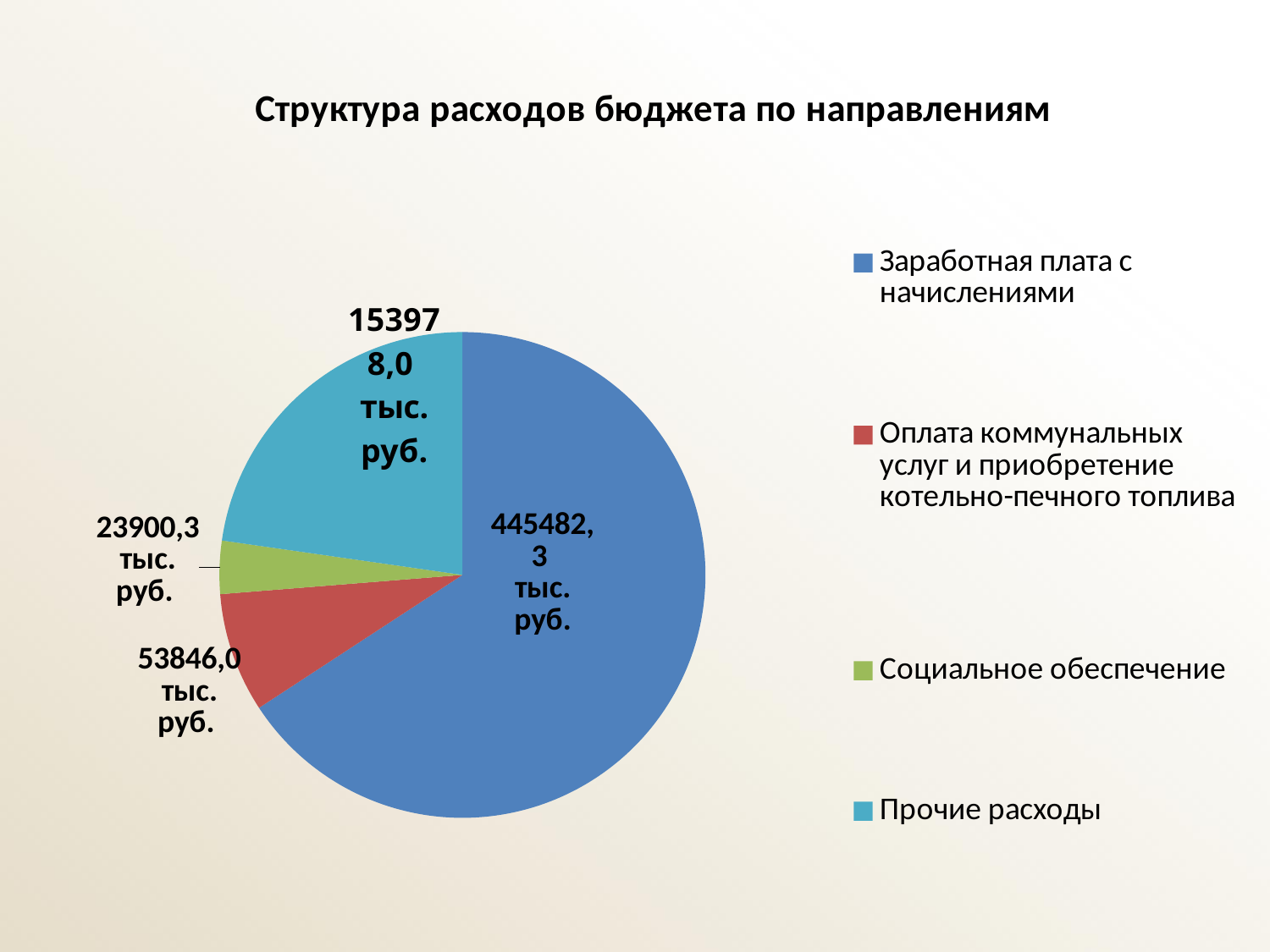
How many entries does the legend list? 4 What kind of chart is shown on the slide? pie chart What is the value for Заработная плата с начислениями? 445482,3 тыс. руб. What is the value for Социальное обеспечение? 23900,3 тыс. руб. Which is larger: Прочие расходы or Оплата коммунальных услуг и приобретение котельно-печного топлива? Прочие расходы What is the value for Прочие расходы? 153978,0 тыс. руб. What is the value for Оплата коммунальных услуг и приобретение котельно-печного топлива? 53846,0 тыс. руб. How many slices does the pie chart have? 4 Which category has the largest slice of the pie? Заработная плата с начислениями What is the title of the chart? Структура расходов бюджета по направлениям What is the difference between Прочие расходы and Социальное обеспечение? 130077,7 тыс. руб. Which category has the smallest slice of the pie? Социальное обеспечение